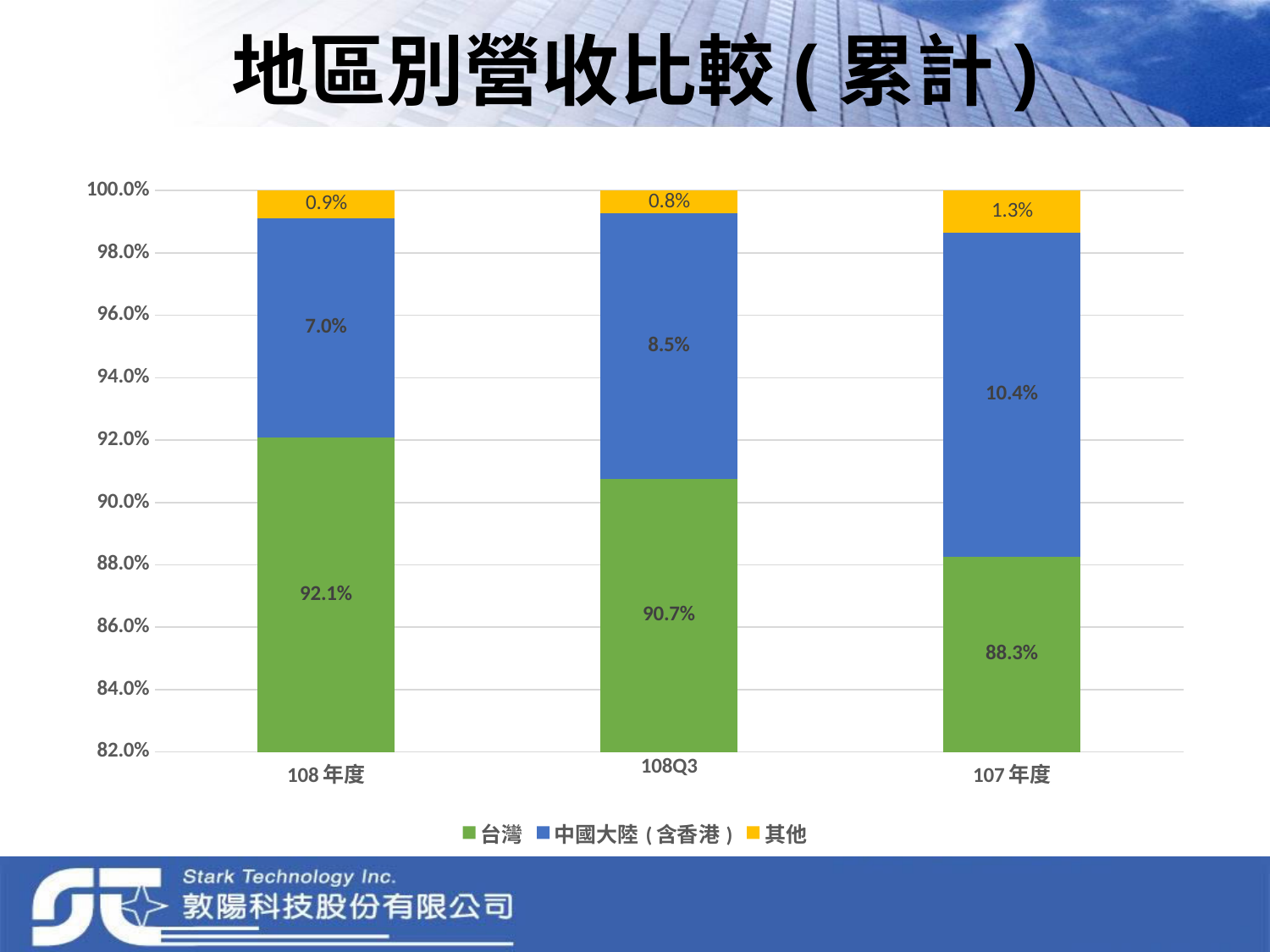
What is the difference between the 台灣 values for 108 年度 and 107 年度? 3.8% How many categories are shown on the x axis? 3 What kind of chart is shown on the slide? Stacked bar chart How many series does the legend list? 3 Which is larger: the 中國大陸（含香港）value for 108Q3 or for 107 年度? 107 年度 Which category has the lowest value for 中國大陸（含香港）? 108 年度 What is the title of the chart on the slide? 地區別營收比較（累計） What is the value for 中國大陸（含香港）in 107 年度? 10.4% Do the 台灣 values rise or fall from 108 年度 to 107 年度 along the x axis? Fall What is the value for 其他 in 108Q3? 0.8% Which category has the highest value for 台灣? 108 年度 What is the value for 台灣 in 108 年度? 92.1%